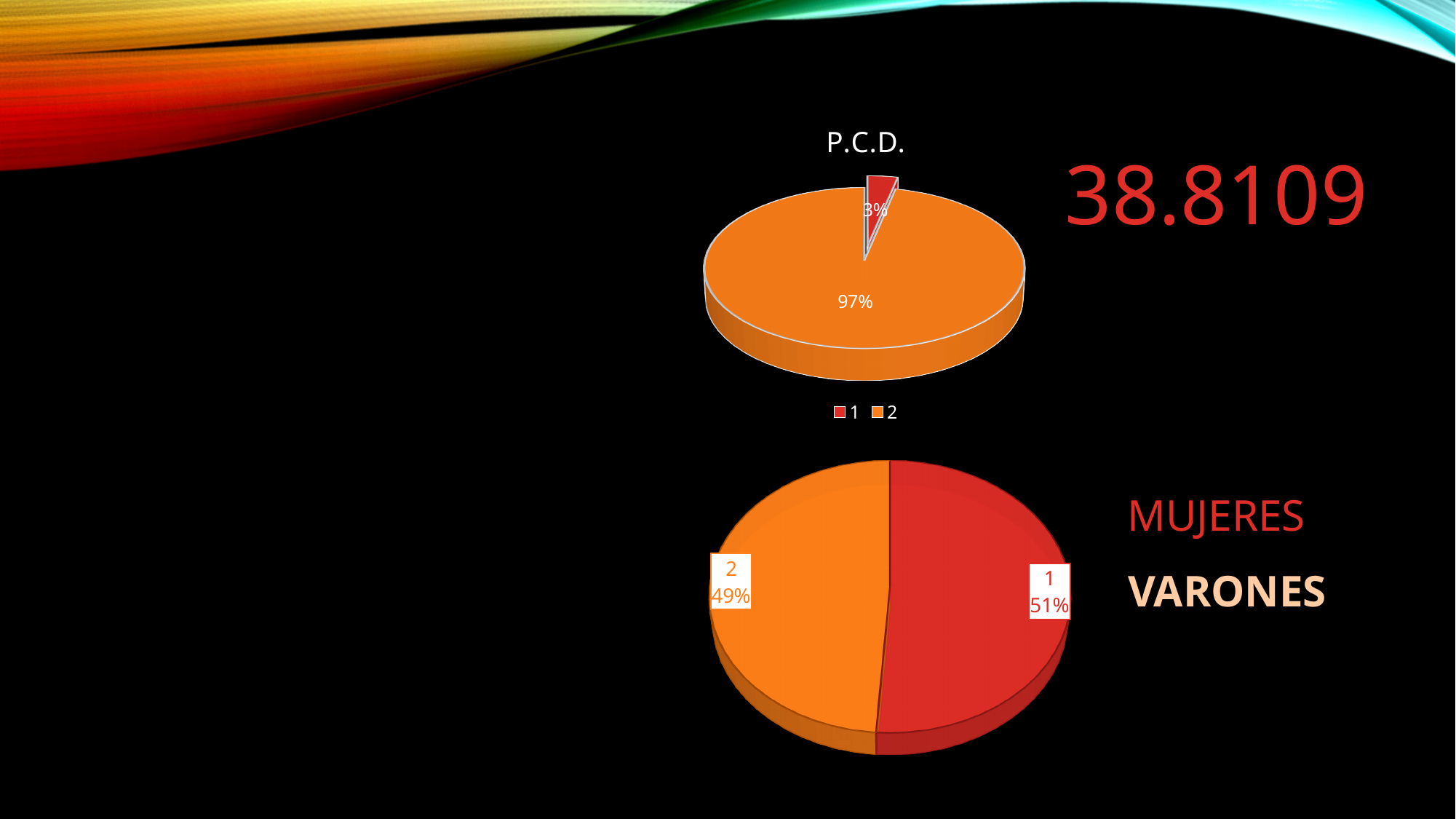
In the top chart titled "P.C.D.", which slice is the largest? 2 How many entries does the legend of the top chart titled "P.C.D." list? 2 In the top chart titled "P.C.D.", what percentage does slice 1 represent? 3% What kind of chart is the bottom chart? pie chart How many slices does the bottom pie chart have? 2 In the bottom chart, which slice is the smallest? 2 What kind of chart is the top chart titled "P.C.D."? pie chart In the bottom chart, what percentage does slice 2 represent? 49% In the bottom chart, what percentage does slice 1 represent? 51% What is the title of the top chart? P.C.D. In the top chart titled "P.C.D.", what percentage does slice 2 represent? 97% In the top chart titled "P.C.D.", what is the difference in percentage points between slice 2 and slice 1? 94